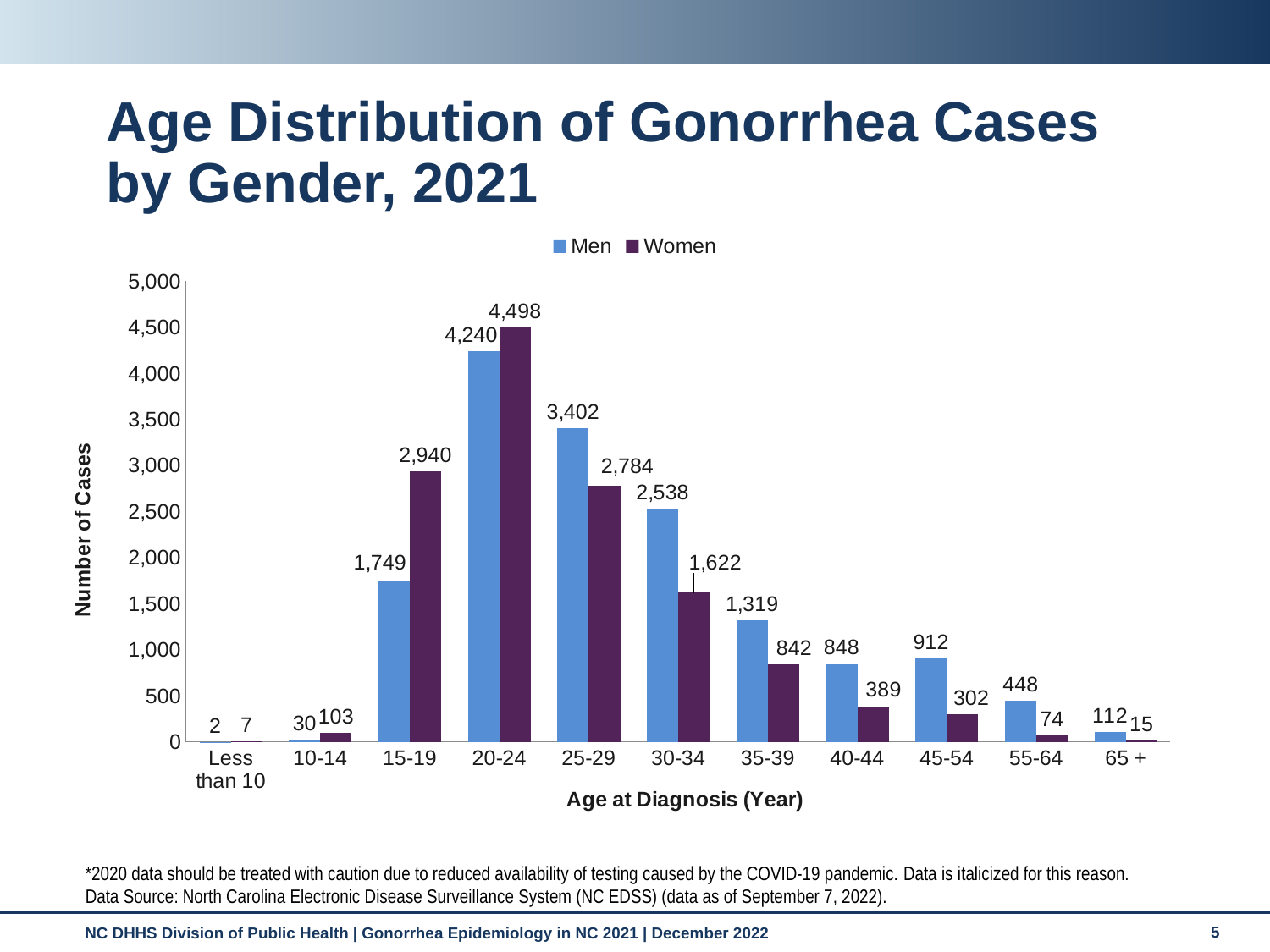
What type of chart is shown on the slide? Bar chart What is the total number of cases (Men plus Women) in the 55-64 age group? 522 How many age groups are shown on the x axis? 11 What is the difference between Men and Women cases in the 20-24 age group? 258 What is the number of gonorrhea cases for Men in the 25-29 age group? 3,402 Which age group has the lowest number of cases for Men? Less than 10 How many series does the legend list? 2 In the 30-34 age group, which is larger, the number of cases for Men or for Women? Men What is the number of cases for Women in the 45-54 age group? 302 What is the number of gonorrhea cases for Women in the 15-19 age group? 2,940 Which age group has the highest number of cases for Women? 20-24 What is the label of the y axis? Number of Cases